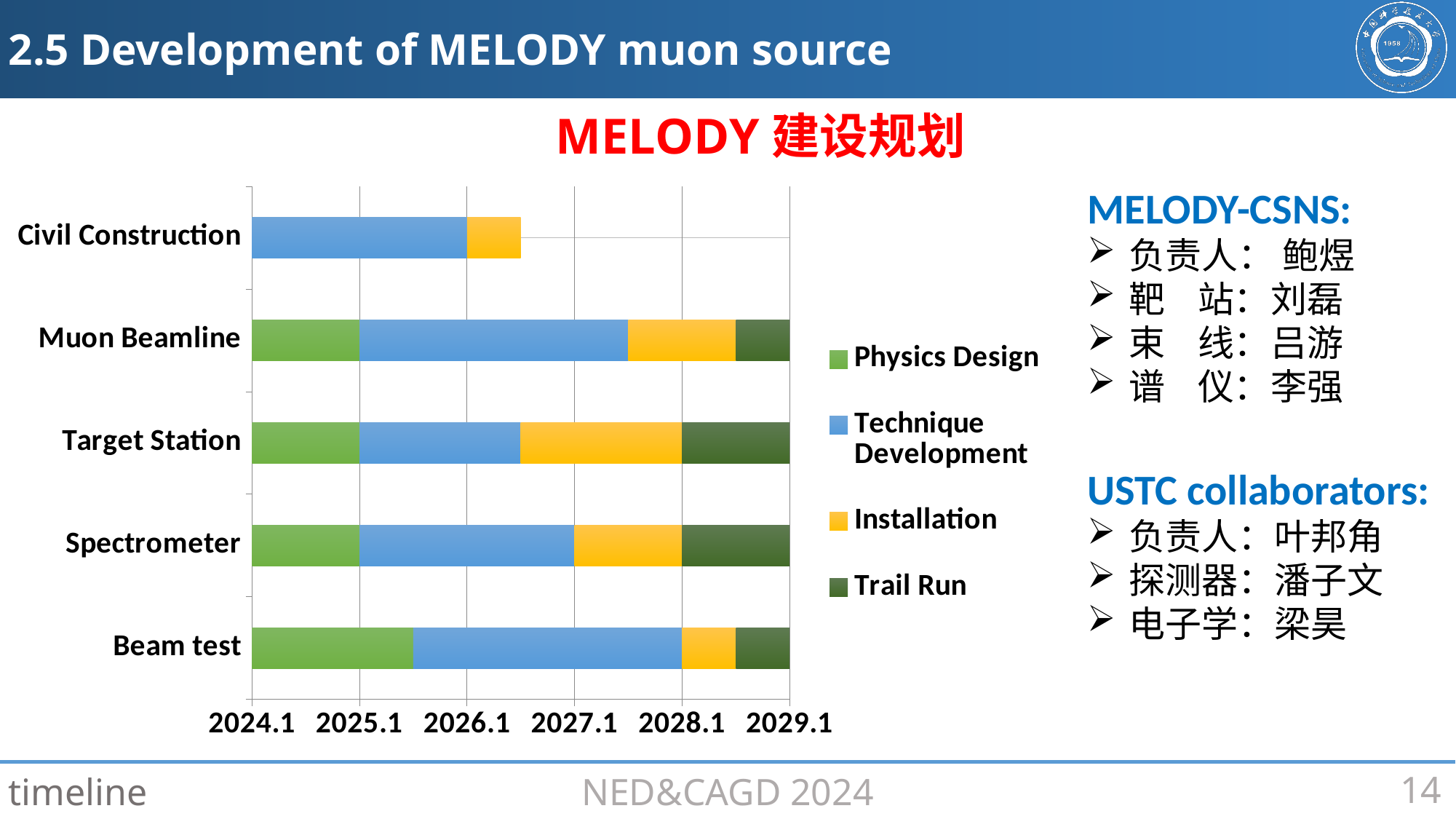
Which category has no Physics Design segment? Civil Construction Which category has the longest Technique Development segment? Muon Beamline and Beam test (tied) Which category's bar ends earliest on the time axis? Civil Construction Which category has the longest Physics Design segment? Beam test Which has the longer Installation segment, Target Station or Muon Beamline? Target Station Does the Technique Development segment for Muon Beamline extend past 2027.1? yes How many series does the chart legend list? 4 Which series in the legend is shown in yellow? Installation Does the Civil Construction bar end before or after 2027.1? before Which series in the legend is shown in dark green? Trail Run What kind of chart is shown on the slide? Stacked horizontal bar chart How many categories (work packages) are listed on the vertical axis of the chart? 5